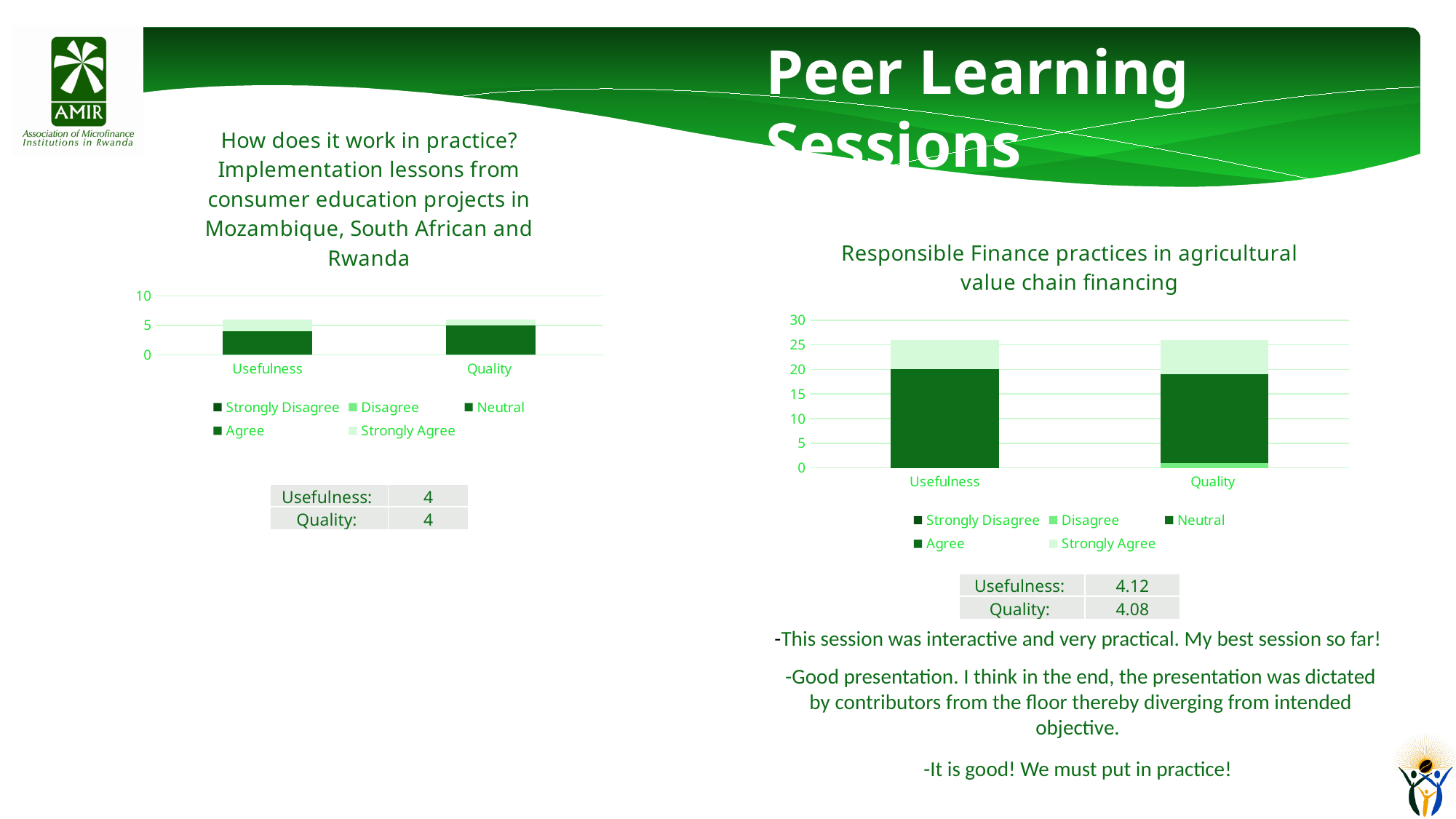
In the chart titled "Responsible Finance practices in agricultural value chain financing", is the total height of the Usefulness bar greater or less than 20? greater How many categories are shown on the x axis of the left chart about implementation lessons from consumer education projects? 2 In the left chart about implementation lessons from consumer education projects, which category has the larger Strongly Agree segment, Usefulness or Quality? Usefulness What kind of chart is the chart titled "Responsible Finance practices in agricultural value chain financing"? bar chart What are the two categories on the x axis of the chart titled "Responsible Finance practices in agricultural value chain financing"? Usefulness and Quality In the left chart about implementation lessons from consumer education projects, which category has the larger Agree segment, Usefulness or Quality? Quality What kind of chart is the left chart about implementation lessons from consumer education projects? bar chart How many series does the legend list in the chart titled "Responsible Finance practices in agricultural value chain financing"? 5 What is the highest value shown on the y axis of the chart titled "Responsible Finance practices in agricultural value chain financing"? 30 In the left chart about implementation lessons from consumer education projects, is the Agree segment of the Usefulness bar greater or less than 5? less In the left chart about implementation lessons from consumer education projects, is the total height of the Usefulness bar greater or less than 5? greater